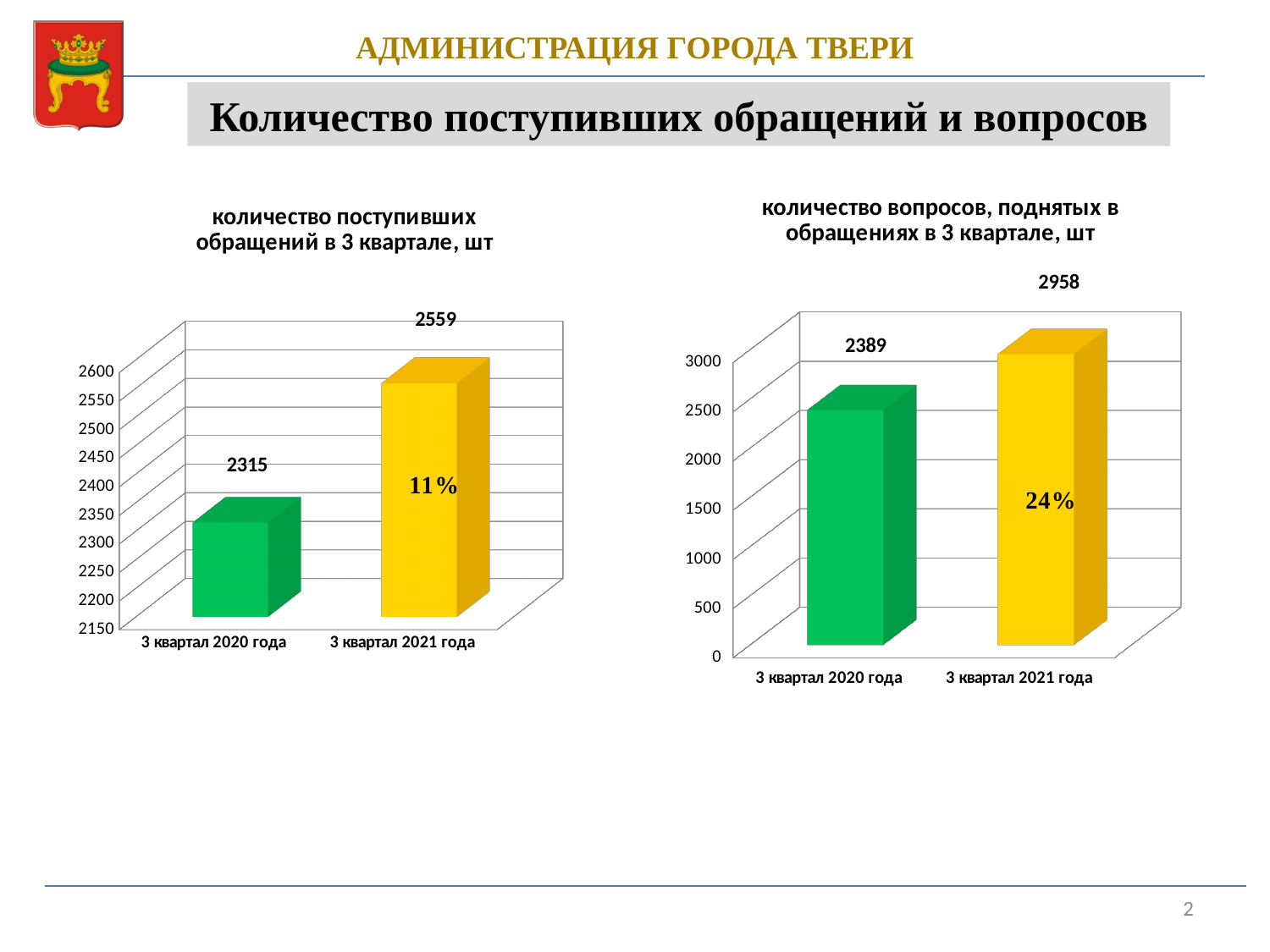
In the right chart 'количество вопросов, поднятых в обращениях в 3 квартале, шт', what is the value for 3 квартал 2021 года? 2958 How many categories are shown in the right chart? 2 In the left chart, what is the difference between the values for 3 квартал 2021 года and 3 квартал 2020 года? 244 In the right chart, is the value for 3 квартал 2020 года greater or less than 2500? less In the left chart 'количество поступивших обращений в 3 квартале, шт', what is the value for 3 квартал 2021 года? 2559 What percentage label is printed on the 3 квартал 2021 года bar in the right chart? 24% In the left chart 'количество поступивших обращений в 3 квартале, шт', what is the value for 3 квартал 2020 года? 2315 What kind of chart is the left chart? bar chart In the right chart, what is the difference between the values for 3 квартал 2021 года and 3 квартал 2020 года? 569 In the right chart 'количество вопросов, поднятых в обращениях в 3 квартале, шт', what is the value for 3 квартал 2020 года? 2389 In the left chart, which quarter has the higher number of received appeals? 3 квартал 2021 года In the right chart, which quarter has the lower number of questions raised? 3 квартал 2020 года